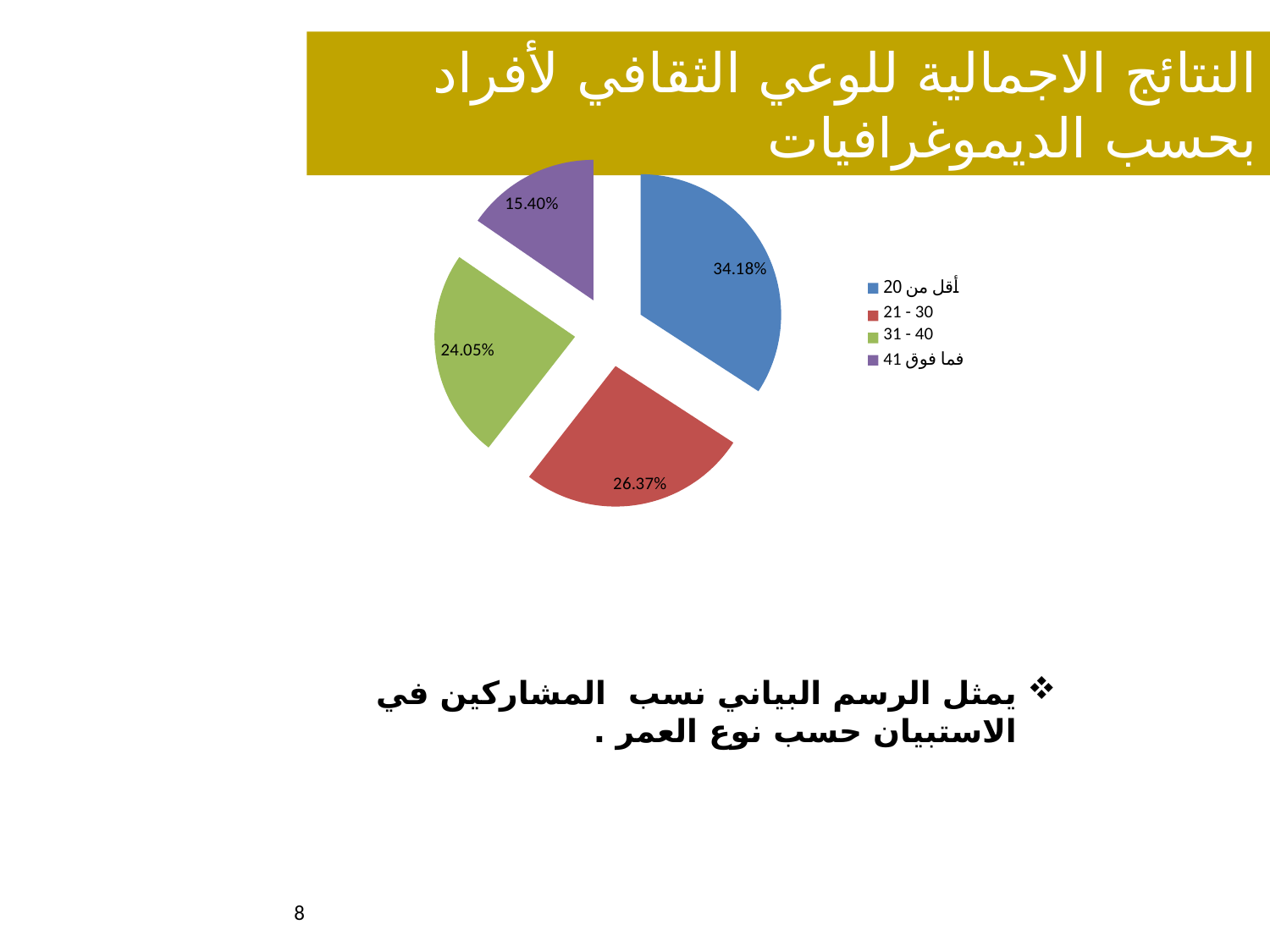
What kind of chart is shown on the slide? pie chart What is the difference between the "أقل من 20" share and the "41 فما فوق" share? 18.78% How many slices does the pie chart have? 4 Which age group has the smallest share of the pie? 41 فما فوق How many entries does the legend list? 4 Which is larger, the share for "21 - 30" or the share for "31 - 40"? 21 - 30 What percentage is shown for the "41 فما فوق" slice? 15.40% What percentage is shown for the "21 - 30" slice? 26.37% Which age group has the largest share of the pie? أقل من 20 What percentage is shown for the "أقل من 20" slice? 34.18% What percentage is shown for the "31 - 40" slice? 24.05% What colour is the slice for "31 - 40"? green